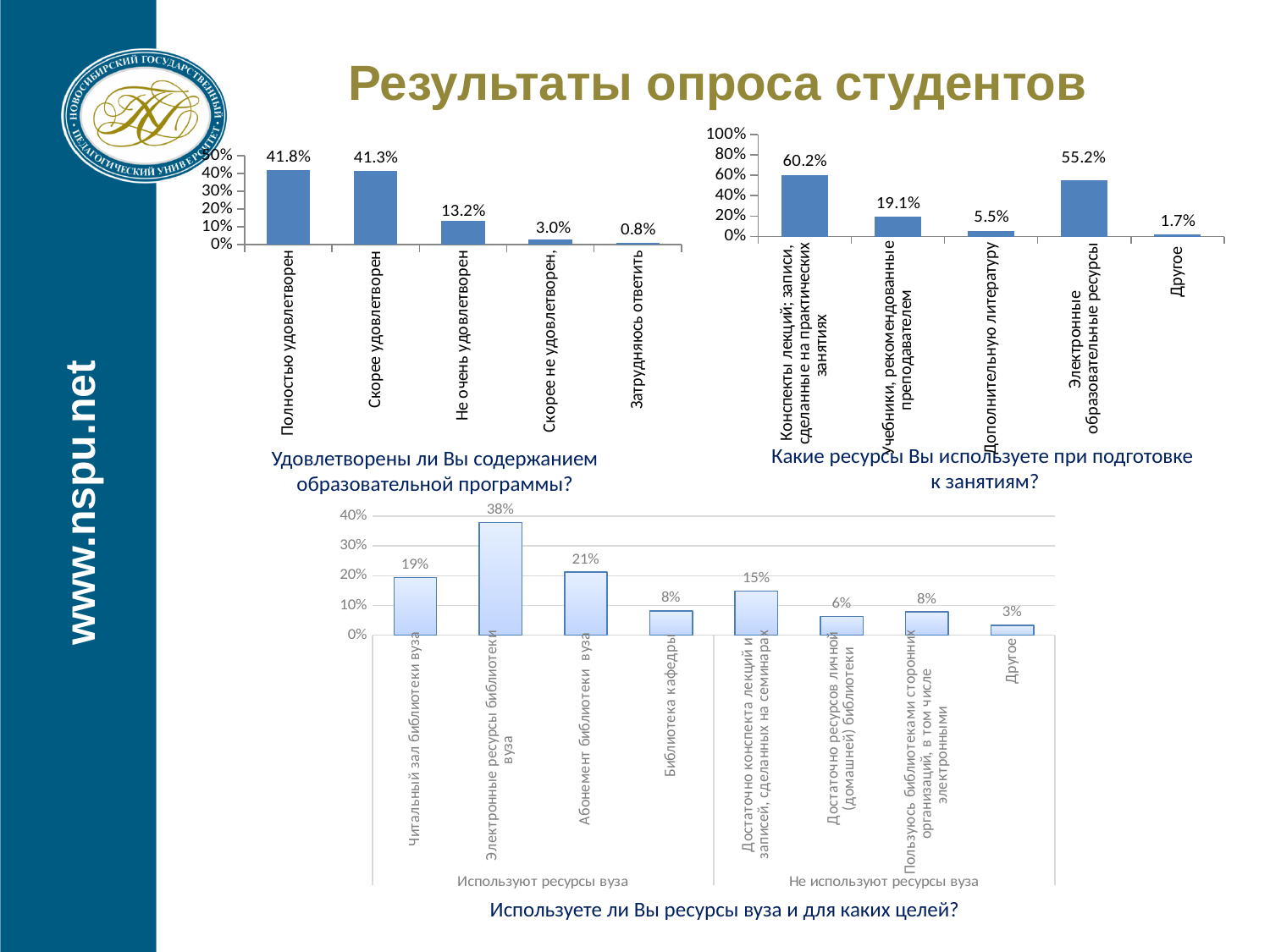
In the chart titled "Используете ли Вы ресурсы вуза и для каких целей?", how many categories are shown? 8 In the chart titled "Удовлетворены ли Вы содержанием образовательной программы?", which category has the lowest value? Затрудняюсь ответить What type of chart is the chart titled "Используете ли Вы ресурсы вуза и для каких целей?"? Bar chart In the chart titled "Какие ресурсы Вы используете при подготовке к занятиям?", which category has the lowest value? Другое In the chart titled "Используете ли Вы ресурсы вуза и для каких целей?", which is larger: "Читальный зал библиотеки вуза" or "Достаточно конспекта лекций и записей, сделанных на семинарах"? Читальный зал библиотеки вуза In the chart titled "Какие ресурсы Вы используете при подготовке к занятиям?", what is the value for "Электронные образовательные ресурсы"? 55.2% In the chart titled "Удовлетворены ли Вы содержанием образовательной программы?", how many categories are shown? 5 In the chart titled "Удовлетворены ли Вы содержанием образовательной программы?", what is the value for "Не очень удовлетворен"? 13.2% In the chart titled "Используете ли Вы ресурсы вуза и для каких целей?", which category has the highest value? Электронные ресурсы библиотеки вуза In the chart titled "Используете ли Вы ресурсы вуза и для каких целей?", what is the value for "Абонемент библиотеки вуза"? 21% In the chart titled "Какие ресурсы Вы используете при подготовке к занятиям?", which category has the highest value? Конспекты лекций; записи, сделанные на практических занятиях In the chart titled "Какие ресурсы Вы используете при подготовке к занятиям?", what is the difference between "Учебники, рекомендованные преподавателем" and "Дополнительную литературу"? 13.6%